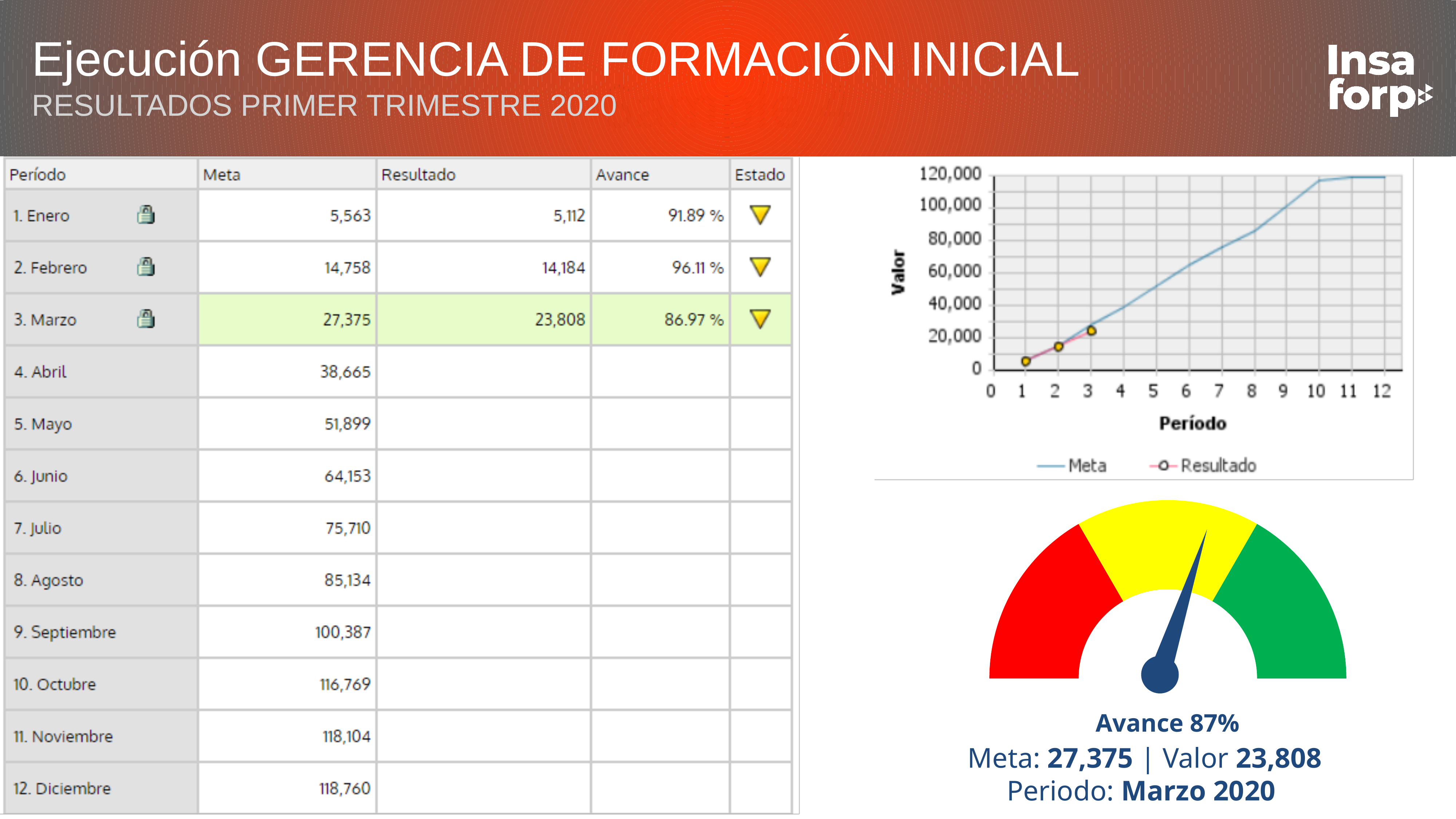
In the line chart at the top right, is the Meta value at period 6 greater or less than 40,000? greater In the line chart at the top right, is the Resultado value at period 3 greater or less than 40,000? less In the gauge chart at the bottom right, what Avance percentage is shown? 87% In the line chart at the top right, how many Resultado data points are plotted? 3 In the line chart at the top right, is the Meta value at period 10 greater or less than 100,000? greater In the line chart at the top right, does the Meta line rise or fall as the period increases from 1 to 12? rise In the line chart at the top right, what is the title of the x axis? Período What kind of chart is the chart at the top right with the Meta and Resultado series? line chart In the line chart at the top right, what are the two legend entries? Meta and Resultado In the gauge chart at the bottom right, what is the Valor shown? 23,808 In the line chart at the top right, how many series does the legend list? 2 In the gauge chart at the bottom right, what is the Meta value shown? 27,375